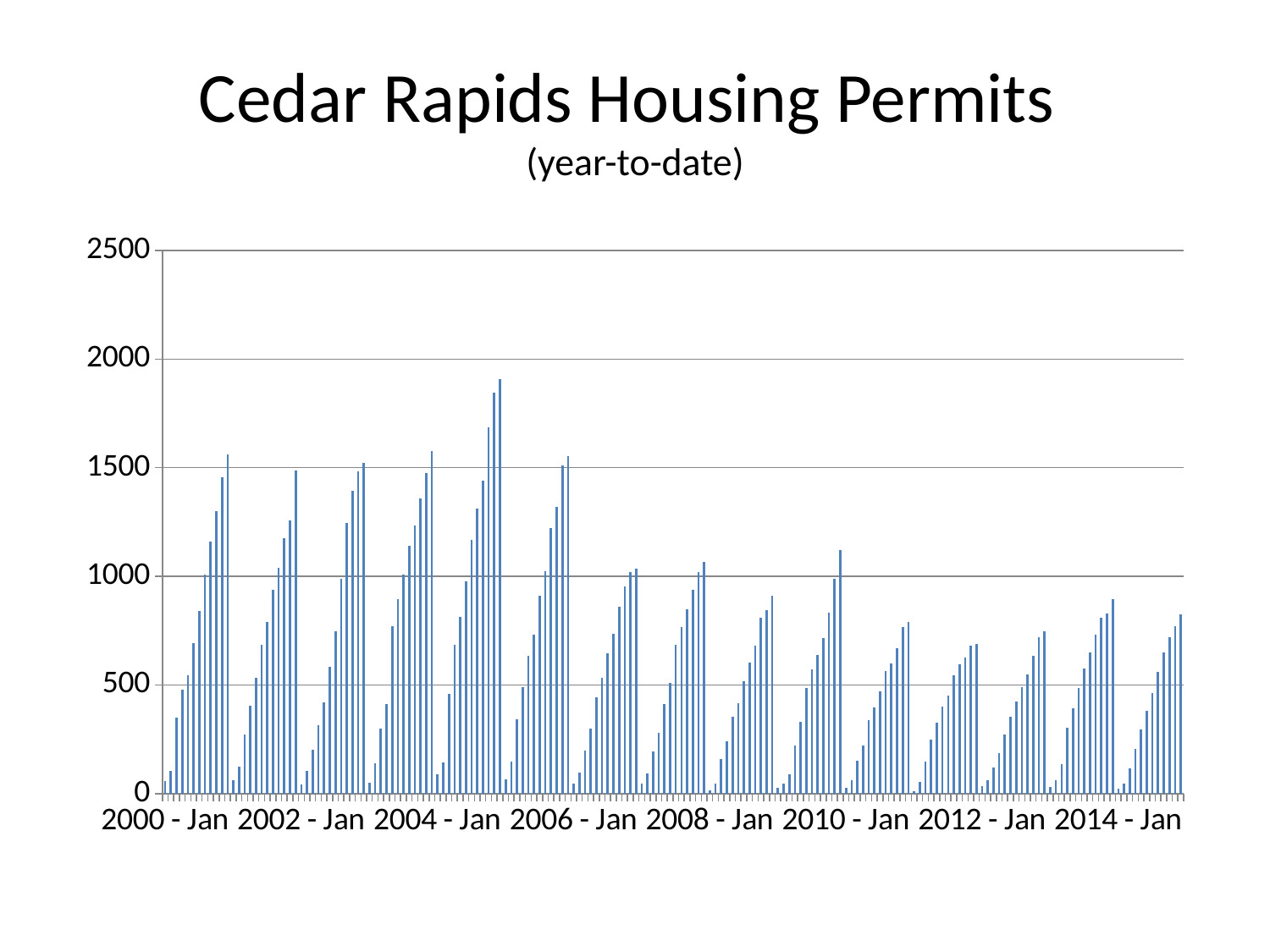
How many year labels are printed along the horizontal axis? 8 What kind of chart is shown on the slide? bar chart What subtitle appears under the chart title? (year-to-date) Within each calendar year, do the year-to-date bars rise or fall from January to December? rise Which year has a higher peak bar, 2005 or 2010? 2005 In which year does the tallest bar on the chart occur? 2004 Is the highest bar in 2000 greater or less than 1000? greater What is the title of the chart on the slide? Cedar Rapids Housing Permits Is the highest bar in 2009 greater or less than 1000? greater Is the tallest bar in 2005 greater or less than 1500? greater What is the highest value shown on the vertical axis? 2500